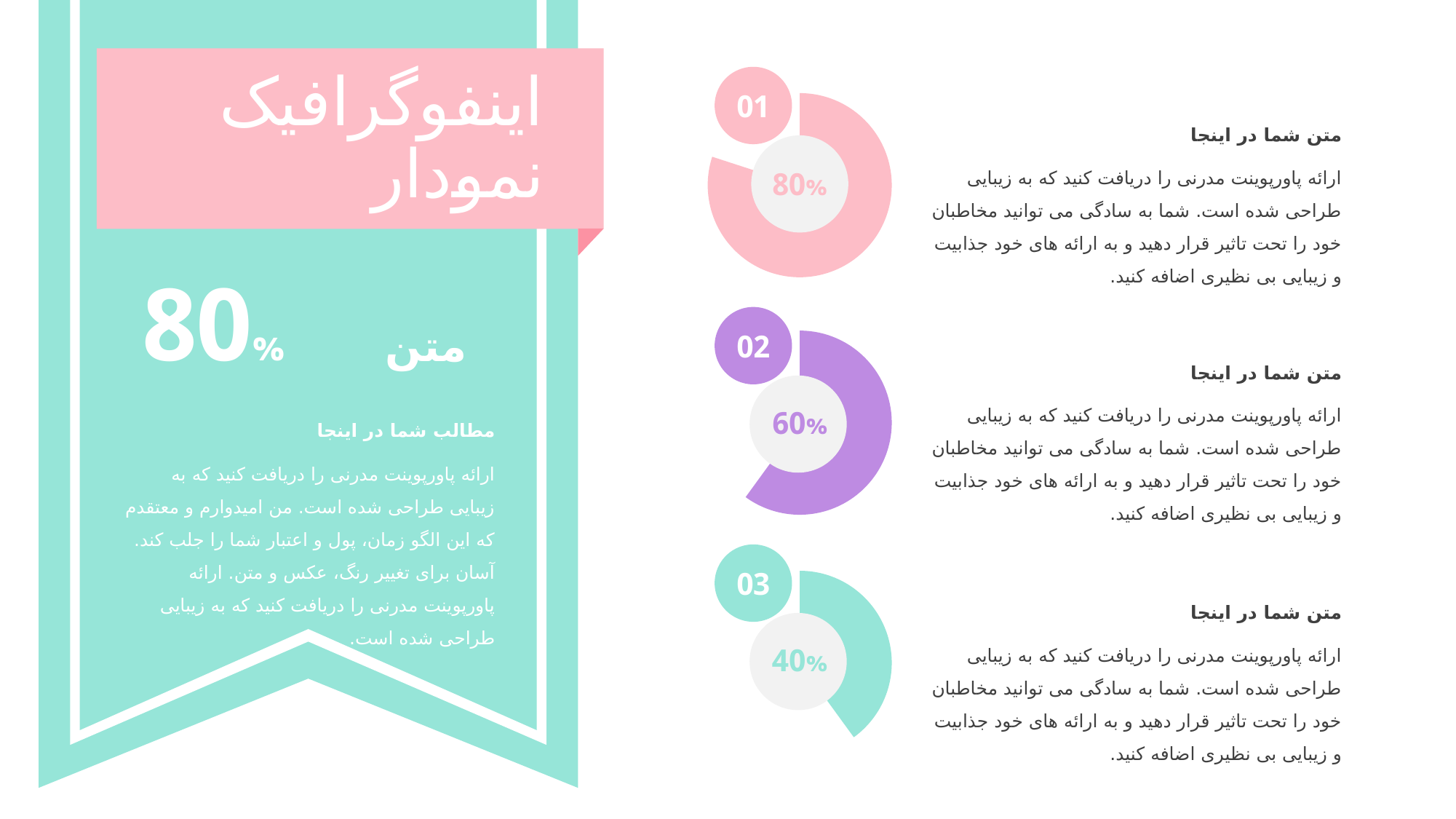
How many donut charts are shown on the slide? 3 What is the difference between the value in chart 01 and the value in chart 02? 20% What value is shown in the donut chart labelled 02? 60% Which shows a larger value, the donut chart labelled 02 or the one labelled 03? 02 Which of the three donut charts shows the lowest percentage? 03 What value is shown in the donut chart labelled 03? 40% What is the difference between the value in chart 01 and the value in chart 03? 40% What colour is the filled ring of the donut chart labelled 02? Purple What value is shown in the donut chart labelled 01? 80% What kind of chart is used for the three numbered items on the right side of the slide? Donut chart Do the percentages in the donut charts rise or fall going from chart 01 down to chart 03? Fall Which of the three donut charts shows the highest percentage? 01